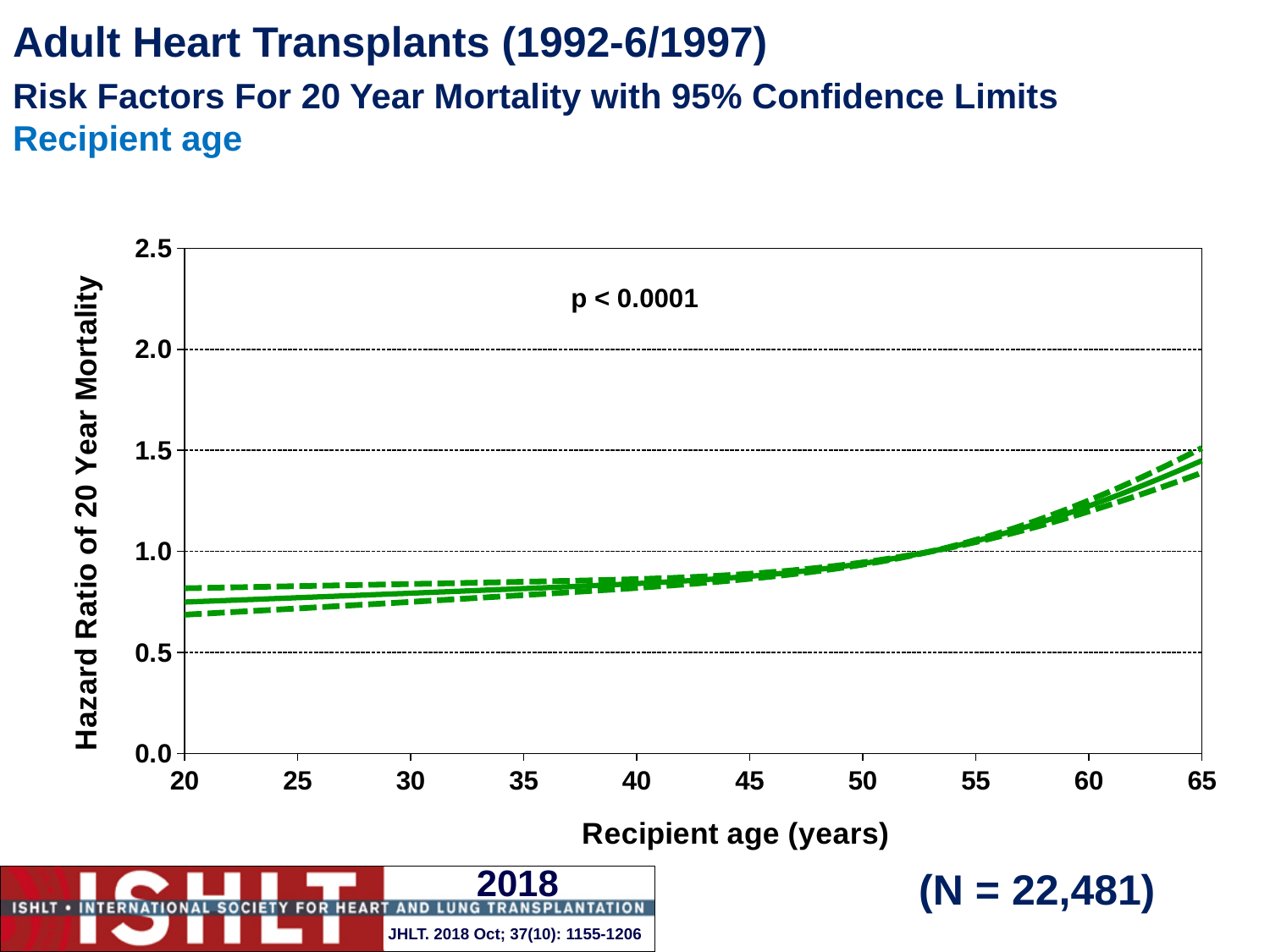
Is the hazard ratio for a recipient age of 65 years greater or less than 2.0? less How many recipient age tick labels are shown on the x axis? 10 What is the label of the y axis? Hazard Ratio of 20 Year Mortality Which recipient age shown on the x axis has the higher hazard ratio, 25 years or 55 years? 55 years Is the hazard ratio for a recipient age of 60 years greater or less than 1.0? greater Does the hazard ratio of 20 year mortality rise or fall as recipient age increases from 20 to 65 years? rise Is the hazard ratio for a recipient age of 30 years greater or less than 0.5? greater What kind of chart is shown on the slide? line chart What p-value is printed on the chart? p < 0.0001